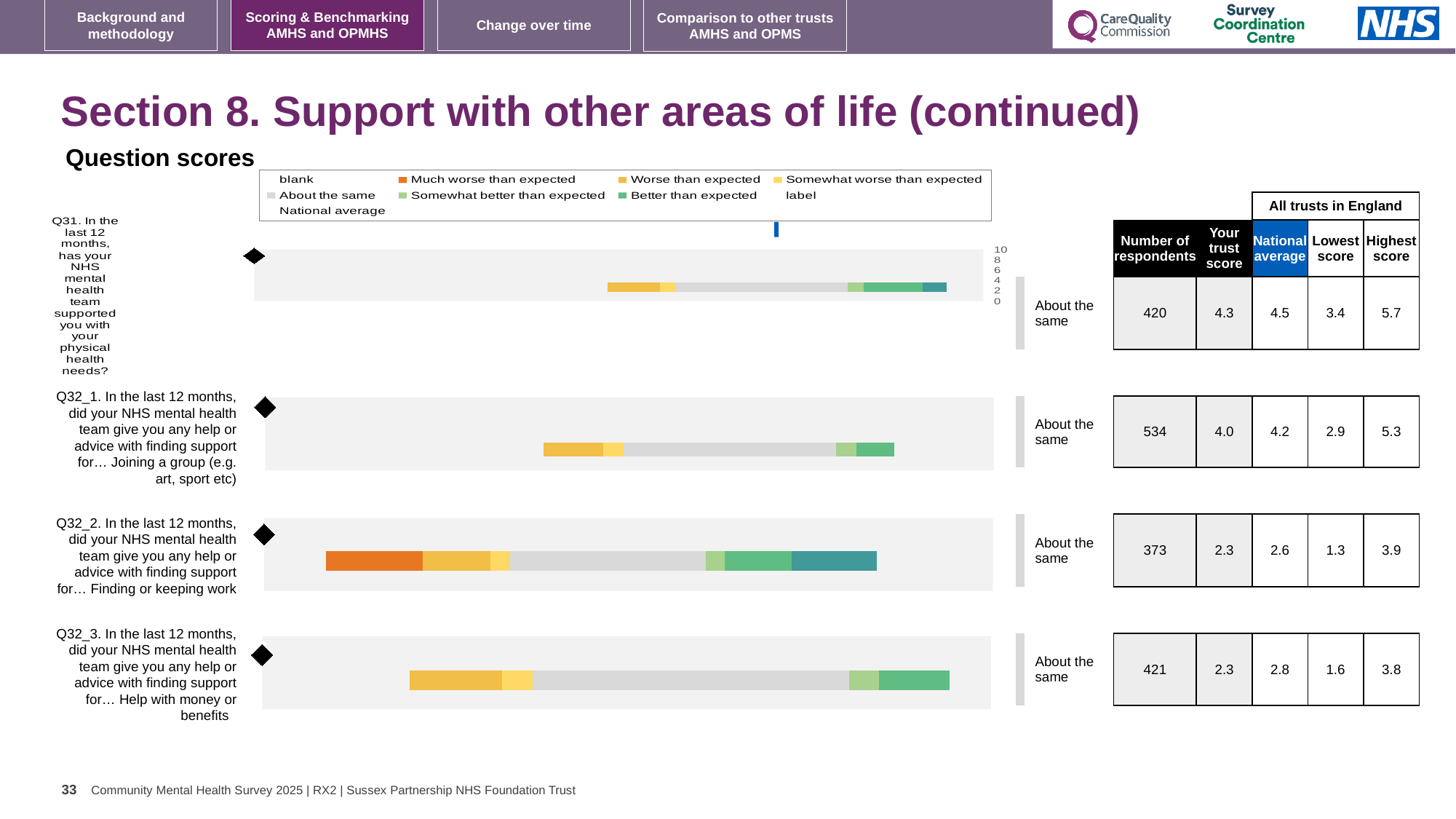
Which question has the lowest 'Lowest score' among all trusts in England? Q32_2 For Q31, what is the difference between the highest score and the lowest score among all trusts in England? 2.3 Which question's bar contains a 'Much worse than expected' (orange) segment? Q32_2 (Finding or keeping work) For Q32_2 (Finding or keeping work), which is larger: your trust score or the national average? National average How many questions (bars) are plotted in the question scores chart? 4 What kind of chart is used to show the question scores on this slide? bar chart What is 'Your trust score' for Q32_1 (Joining a group)? 4.0 In the legend, what colour represents 'Much worse than expected'? orange What is the highest score among all trusts in England for Q32_3 (Help with money or benefits)? 3.8 What is the national average for Q32_2 (Finding or keeping work)? 2.6 Which question has the highest 'Your trust score'? Q31 What is the number of respondents for Q31 (support with physical health needs)? 420